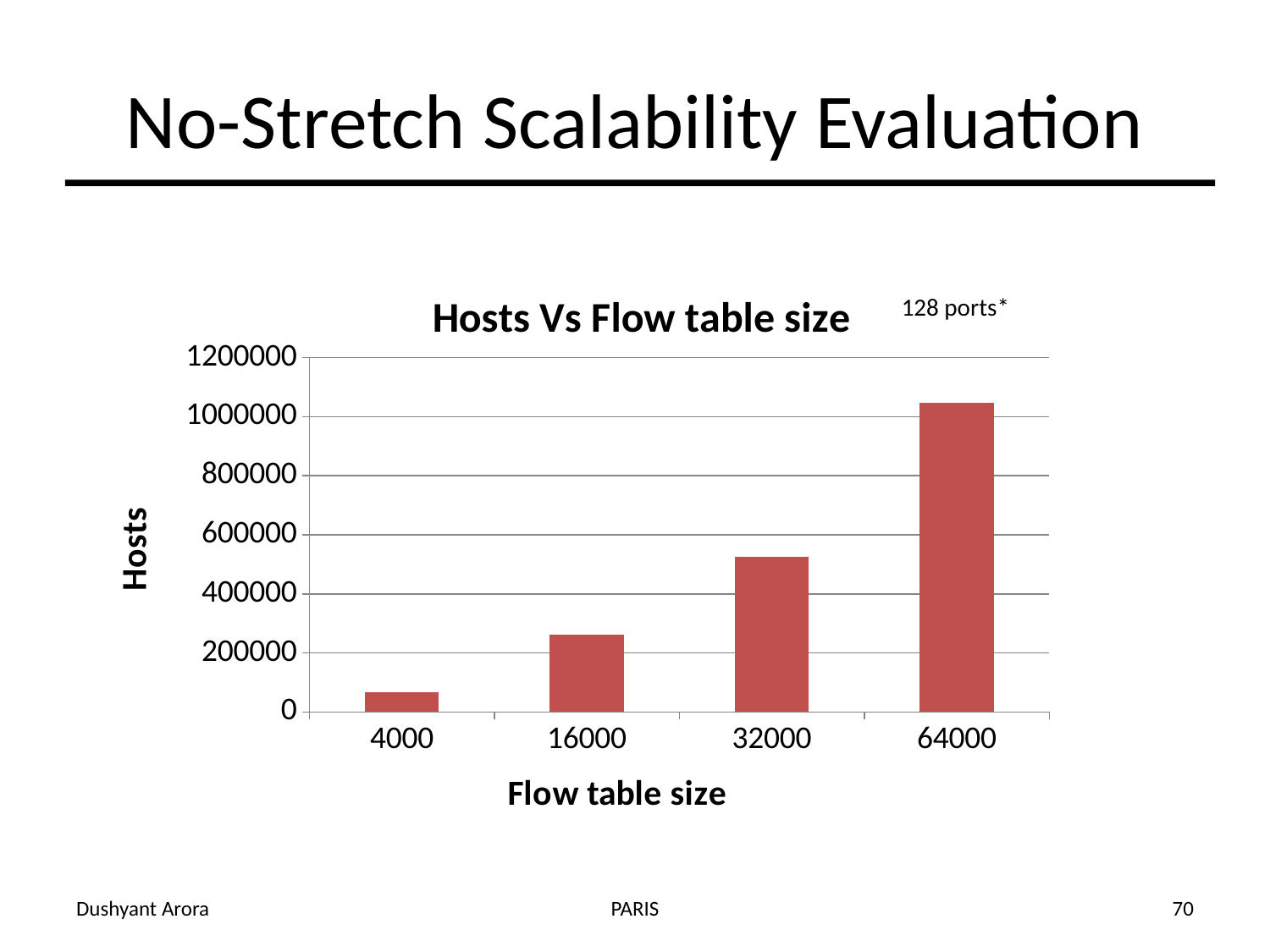
What is the label of the vertical axis of the chart? Hosts Which has more hosts: a flow table size of 16000 or 32000? 32000 What is the title of the chart? Hosts Vs Flow table size Is the number of hosts for a flow table size of 4000 greater or less than 200000? less Do the number of hosts rise or fall as the flow table size increases along the x axis? rise Which flow table size has the lowest number of hosts? 4000 How many flow table size categories are plotted in the chart? 4 Is the number of hosts for a flow table size of 16000 greater or less than 200000? greater What kind of chart is shown on the slide? bar chart Is the number of hosts for a flow table size of 32000 greater or less than 600000? less Which flow table size has the highest number of hosts? 64000